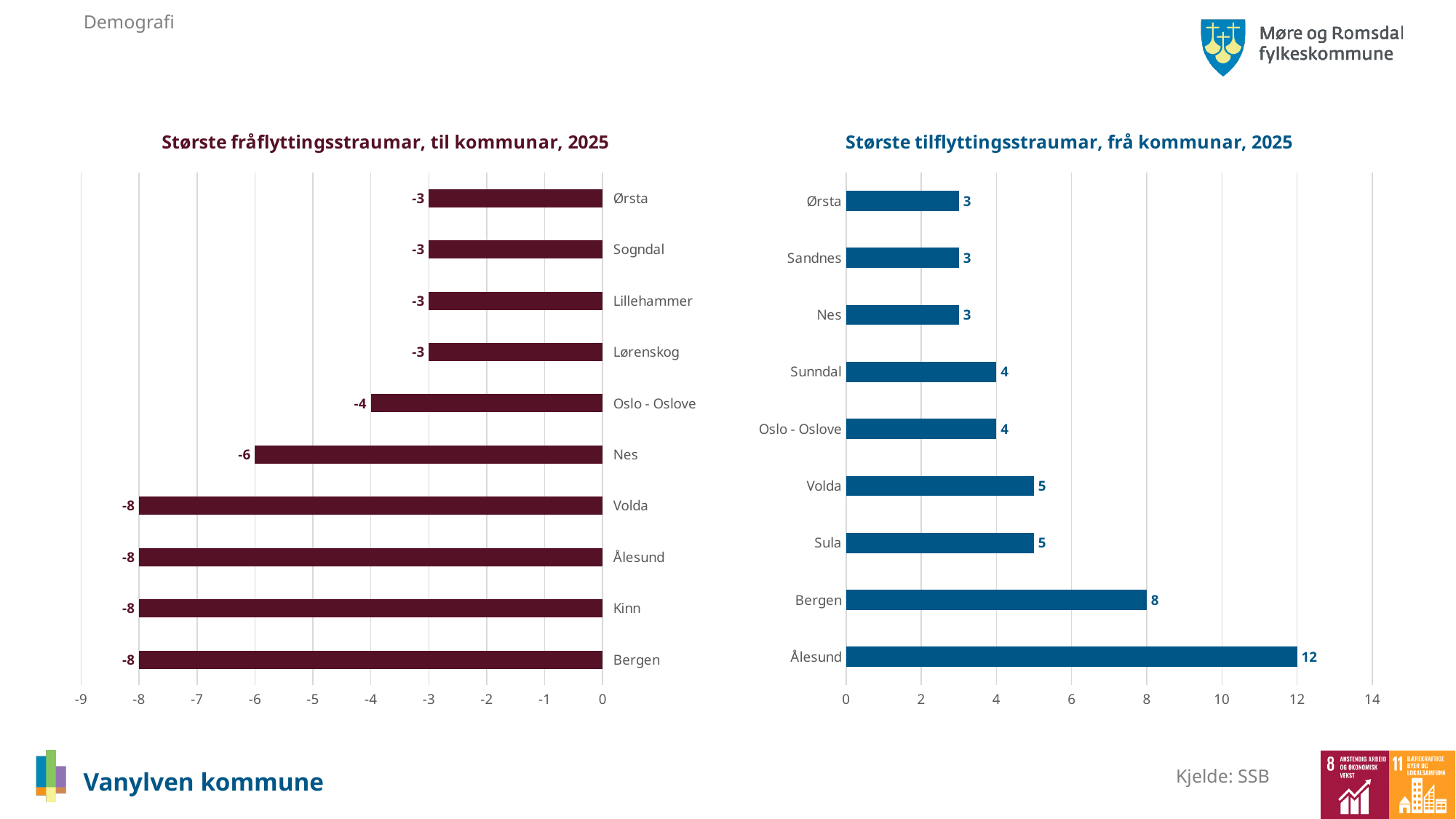
In the chart 'Største fråflyttingsstraumar, til kommunar, 2025', what is the value for Nes? -6 In the chart 'Største tilflyttingsstraumar, frå kommunar, 2025', which municipality has the highest value? Ålesund In the chart 'Største fråflyttingsstraumar, til kommunar, 2025', how many municipalities are shown? 10 In the chart 'Største tilflyttingsstraumar, frå kommunar, 2025', what is the value for Bergen? 8 In the chart 'Største tilflyttingsstraumar, frå kommunar, 2025', how many municipalities are shown? 9 In the chart 'Største tilflyttingsstraumar, frå kommunar, 2025', is the value for Ålesund greater or less than 10? greater In the chart 'Største tilflyttingsstraumar, frå kommunar, 2025', which is larger, the value for Volda or the value for Sunndal? Volda In the chart 'Største tilflyttingsstraumar, frå kommunar, 2025', what is the difference between the values for Ålesund and Bergen? 4 In the chart 'Største fråflyttingsstraumar, til kommunar, 2025', what is the value for Oslo - Oslove? -4 What is the source cited at the bottom of the slide? SSB In the chart 'Største tilflyttingsstraumar, frå kommunar, 2025', what is the value for Ålesund? 12 What kind of chart is 'Største fråflyttingsstraumar, til kommunar, 2025'? Bar chart